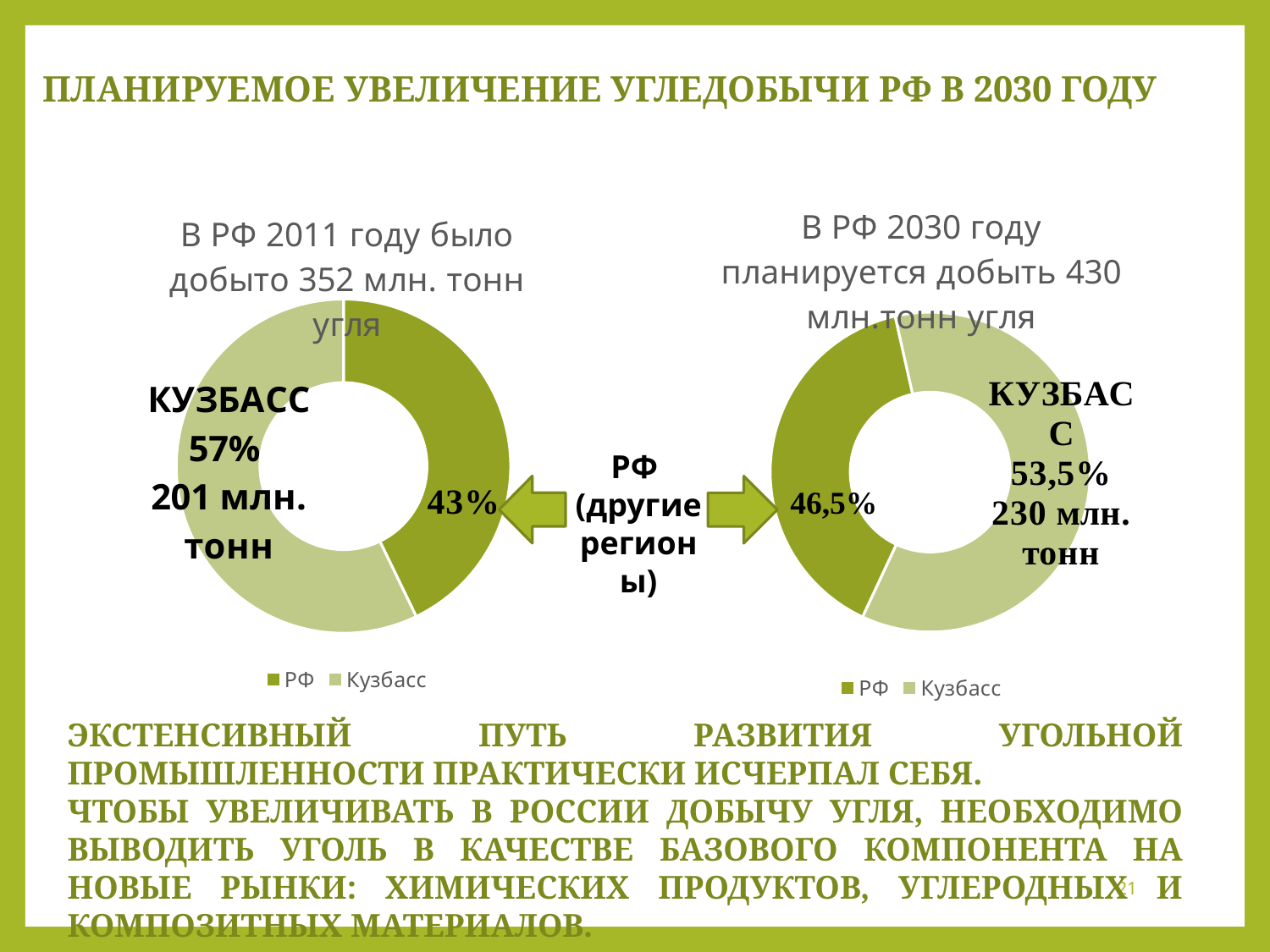
In the right chart (2030), by how many percentage points does the Кузбасс share exceed the РФ share? 7 percentage points What kind of chart is used on this slide for the 2011 and 2030 coal production breakdowns? doughnut chart In the left chart (2011), which slice is larger, РФ or Кузбасс? Кузбасс In the right chart (2030), what share is shown for Кузбасс? 53,5% In the left chart (В РФ 2011 году было добыто 352 млн. тонн угля), what share is shown for РФ (другие регионы)? 43% How many entries does the legend of the left chart (2011) list? 2 How many slices does the right chart (2030) have? 2 In the right chart (В РФ 2030 году планируется добыть 430 млн.тонн угля), what share is shown for РФ (другие регионы)? 46,5% In the left chart (2011), by how many percentage points does the Кузбасс share exceed the РФ share? 14 percentage points In the left chart (2011), what share is shown for Кузбасс? 57% In the right chart (2030), which slice is larger, РФ or Кузбасс? Кузбасс According to the labels next to the charts, how many million tonnes is Кузбасс production in 2011 and how many is planned for 2030? 201 млн. тонн and 230 млн. тонн